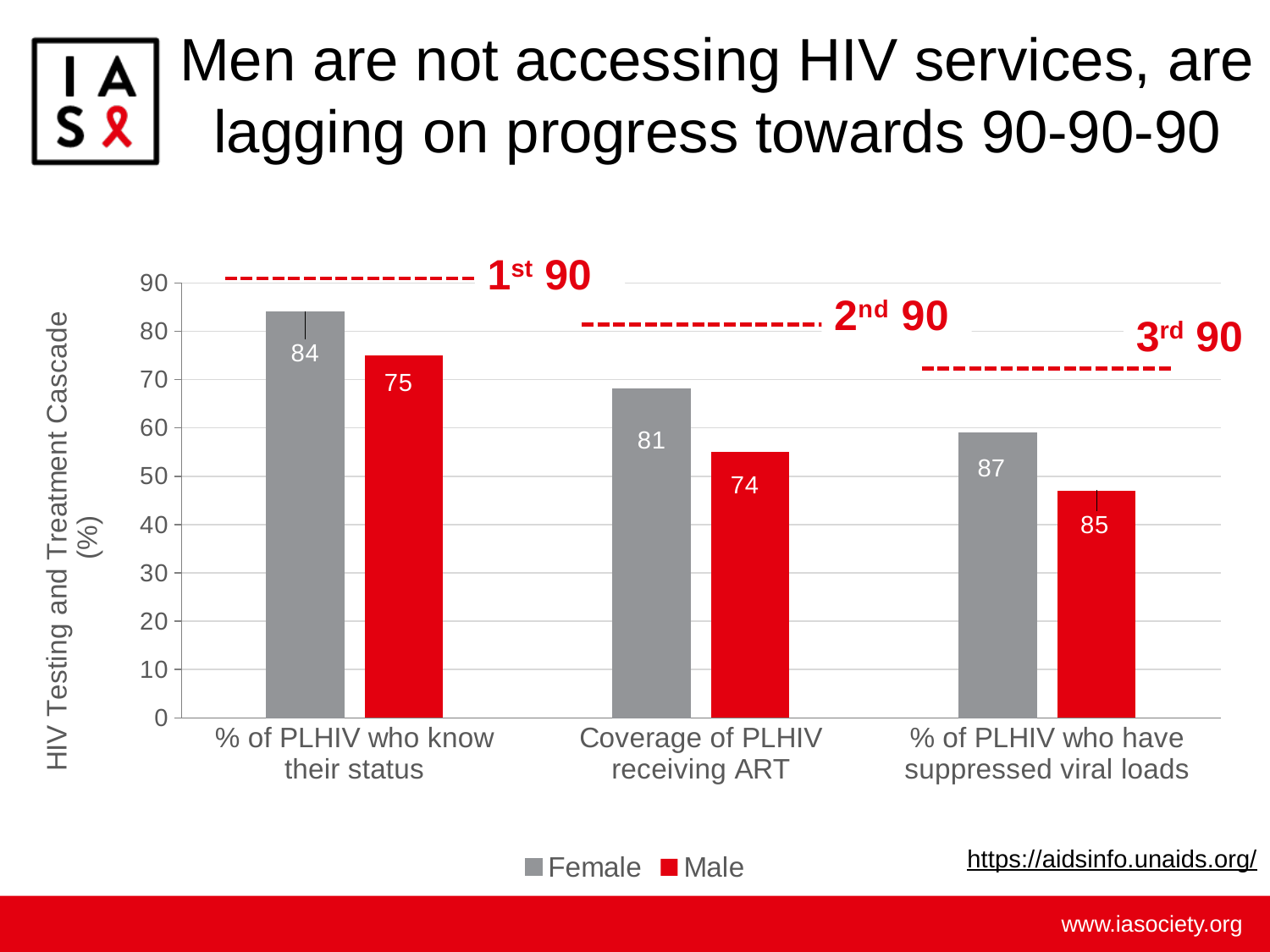
What is the data label for Female in the 'Coverage of PLHIV receiving ART' category? 81 What kind of chart is shown on the slide? Bar chart What is the difference between the Female and Male data labels for '% of PLHIV who know their status'? 9 What is the data label for Male in the 'Coverage of PLHIV receiving ART' category? 74 What is the data label for Male in the '% of PLHIV who know their status' category? 75 How many categories are shown on the x axis of the chart? 3 What is the difference between the Female and Male data labels for 'Coverage of PLHIV receiving ART'? 7 In the 'Coverage of PLHIV receiving ART' category, which series has the larger value, Female or Male? Female How many series does the legend list? 2 What is the data label for Female in the '% of PLHIV who have suppressed viral loads' category? 87 What is the data label for Female in the '% of PLHIV who know their status' category? 84 What is the data label for Male in the '% of PLHIV who have suppressed viral loads' category? 85